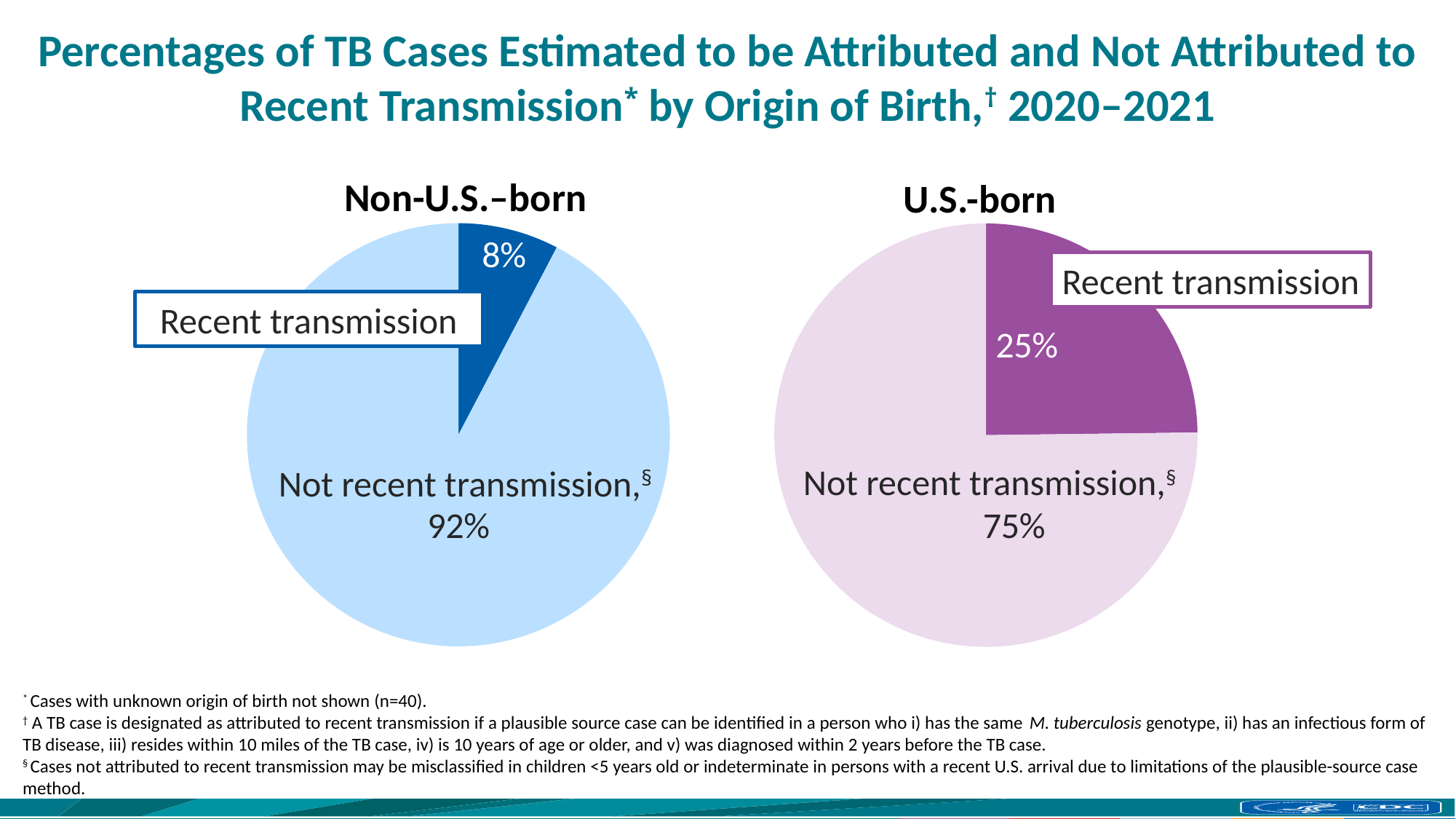
How many slices does the U.S.-born pie chart have? 2 In the Non-U.S.–born pie chart, which slice is the smallest? Recent transmission Which group has a larger share of TB cases attributed to recent transmission, Non-U.S.–born or U.S.-born? U.S.-born How many pie charts are shown on the slide? 2 In the U.S.-born pie chart, what percentage of TB cases is not attributed to recent transmission? 75% In the Non-U.S.–born pie chart, what is the difference between the not recent transmission share and the recent transmission share? 84% In the Non-U.S.–born pie chart, what percentage of TB cases is attributed to recent transmission? 8% In the Non-U.S.–born pie chart, what percentage of TB cases is not attributed to recent transmission? 92% In the U.S.-born pie chart, what percentage of TB cases is attributed to recent transmission? 25% What type of chart is used on this slide? Pie chart In the U.S.-born pie chart, which slice is the largest? Not recent transmission What is the difference between the recent transmission percentage in the U.S.-born chart and the recent transmission percentage in the Non-U.S.–born chart? 17%